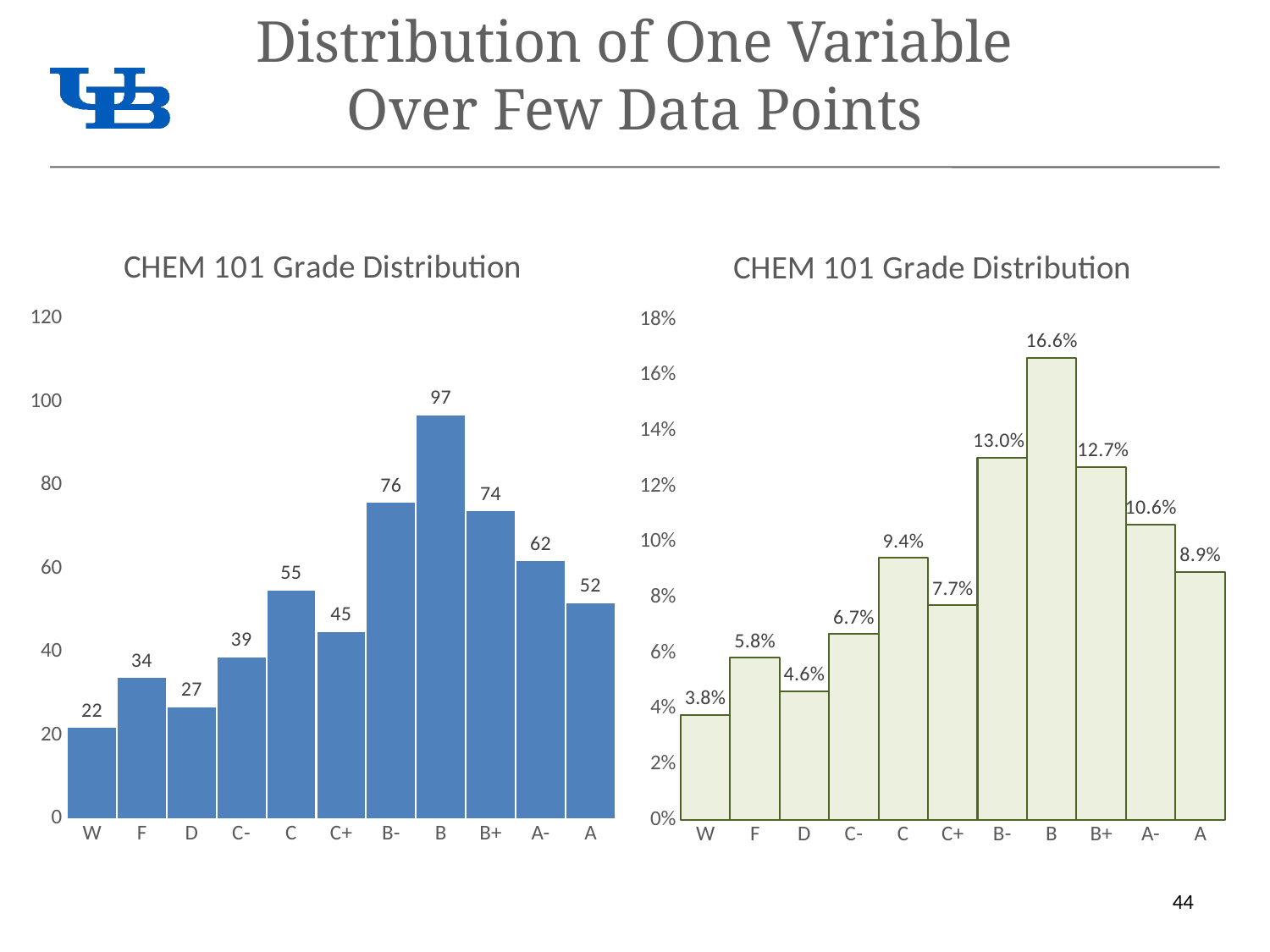
In the left chart (counts), what is the value for grade W? 22 In the left chart (counts), which grade has the highest value? B In the left chart (counts), is the value for C+ greater or less than 40? greater How many grade categories are shown on the x axis of the left chart? 11 In the right chart (percentages), which grade has the lowest value? W What is the title of the left chart? CHEM 101 Grade Distribution In the right chart (percentages), what is the value for grade B? 16.6% In the left chart (counts), what is the value for grade B? 97 In the right chart (percentages), what is the value for grade C? 9.4% What kind of chart is the right chart? bar chart In the left chart (counts), what is the difference between the values for B and B+? 23 In the right chart (percentages), which is larger, the value for A- or the value for A? A-